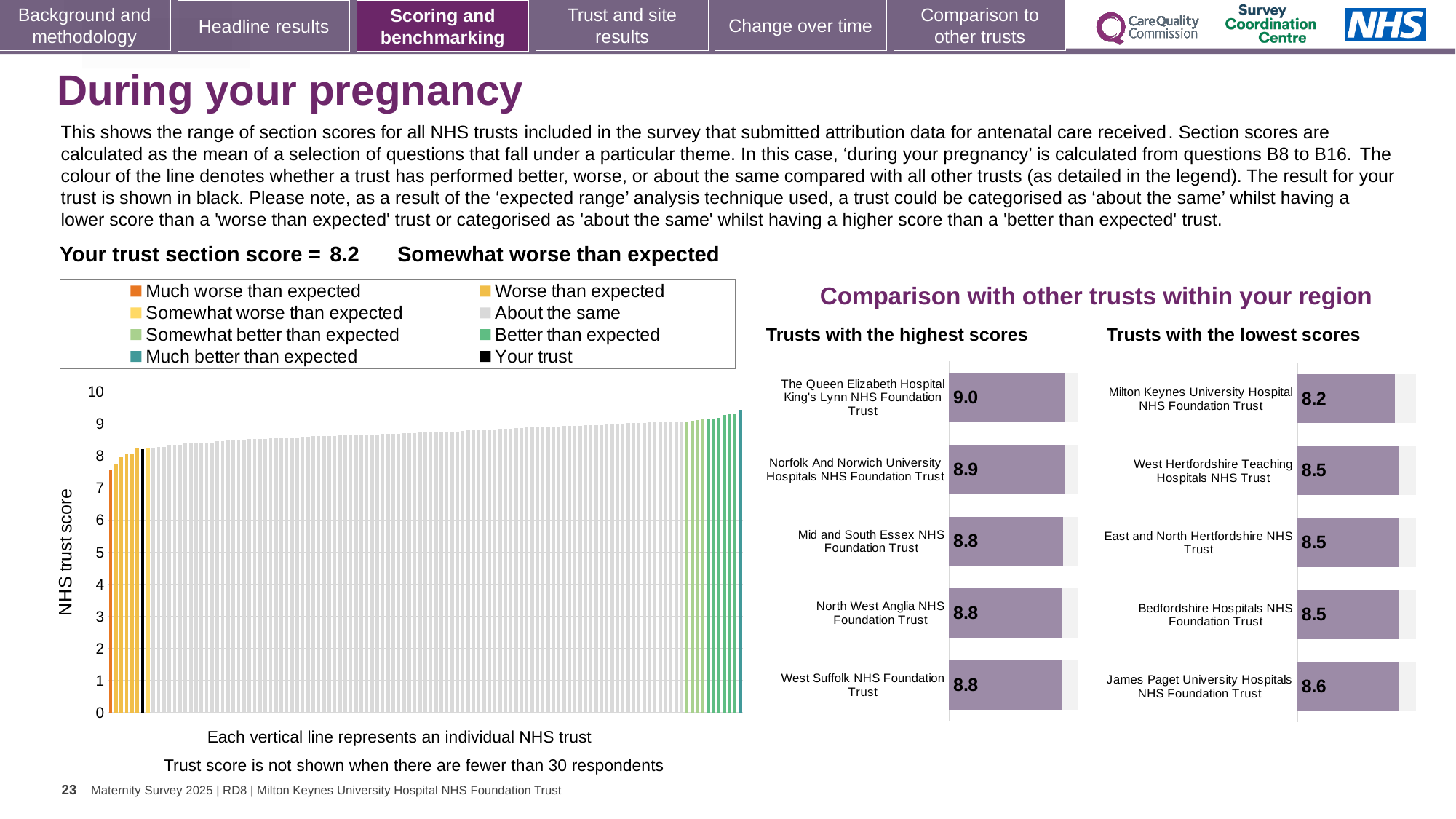
In the 'Trusts with the lowest scores' chart, which trust has the lowest score? Milton Keynes University Hospital NHS Foundation Trust In the 'Trusts with the highest scores' chart, what is the score for Norfolk And Norwich University Hospitals NHS Foundation Trust? 8.9 How many trusts are shown in the 'Trusts with the highest scores' chart? 5 In the 'Trusts with the lowest scores' chart, what is the score for James Paget University Hospitals NHS Foundation Trust? 8.6 Which has the larger score: Norfolk And Norwich University Hospitals NHS Foundation Trust in the highest scores chart or James Paget University Hospitals NHS Foundation Trust in the lowest scores chart? Norfolk And Norwich University Hospitals NHS Foundation Trust In the 'Trusts with the highest scores' chart, which trust has the highest score? The Queen Elizabeth Hospital King's Lynn NHS Foundation Trust How many entries does the legend above the 'NHS trust score' chart list? 8 What is the difference between the score for The Queen Elizabeth Hospital King's Lynn NHS Foundation Trust in the highest scores chart and the score for Milton Keynes University Hospital NHS Foundation Trust in the lowest scores chart? 0.8 What kind of chart is the 'NHS trust score' chart on the left of the slide? Bar chart In the 'Trusts with the lowest scores' chart, what is the score for Milton Keynes University Hospital NHS Foundation Trust? 8.2 In the 'Trusts with the highest scores' chart, what is the score for The Queen Elizabeth Hospital King's Lynn NHS Foundation Trust? 9.0 In the 'NHS trust score' chart on the left, do the trust scores rise or fall from left to right? Rise